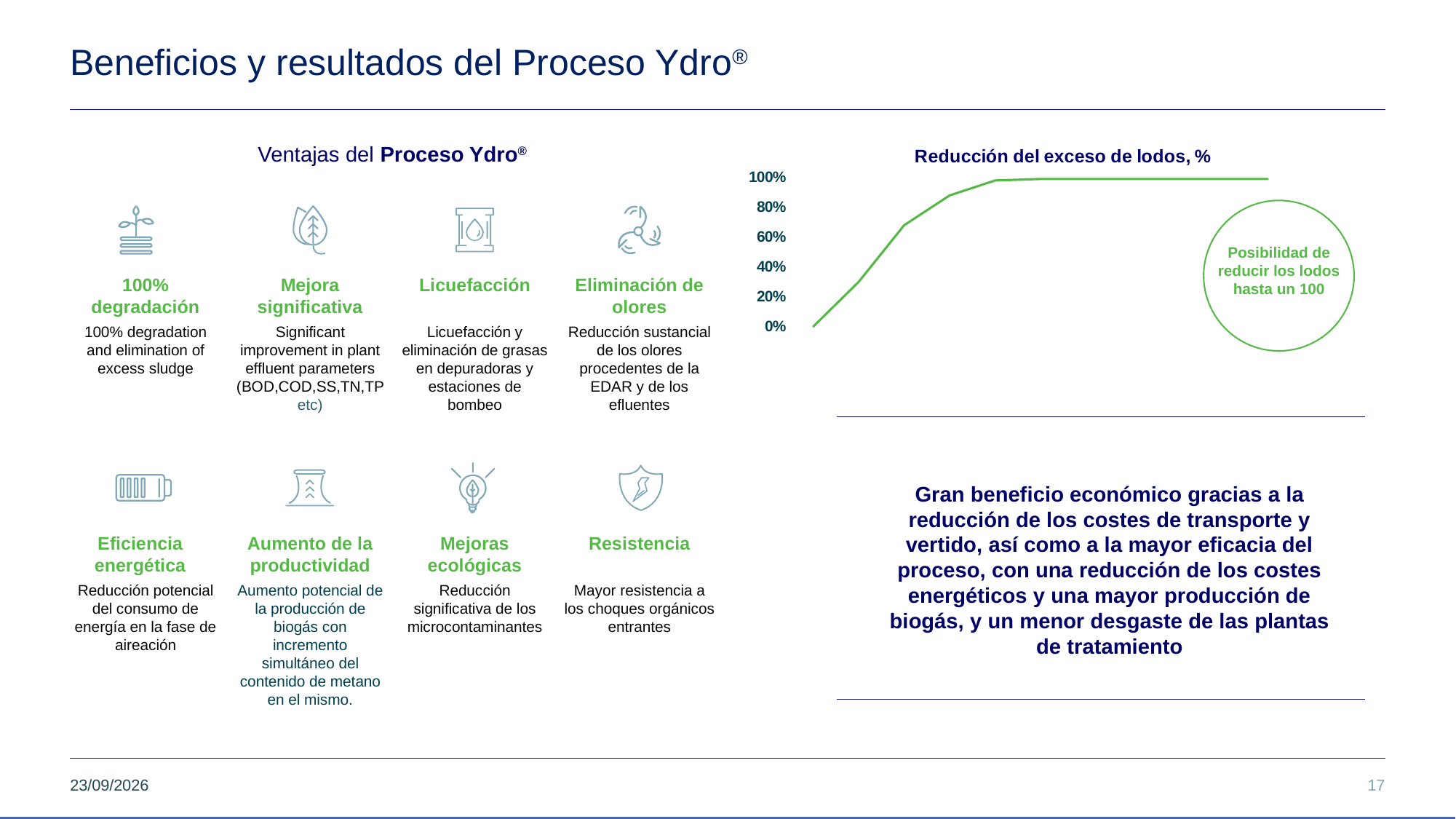
In the chart "Reducción del exceso de lodos, %", what value does the line start at on the left? 0% In the chart "Reducción del exceso de lodos, %", what is the lowest value the line reaches? 0% In the chart "Reducción del exceso de lodos, %", do the values rise or fall along the x axis? rise What is the title of the chart on the right side of the slide? Reducción del exceso de lodos, % In the chart "Reducción del exceso de lodos, %", is the value at the right end of the line greater or less than 80%? greater In the chart "Reducción del exceso de lodos, %", what is the highest tick shown on the y axis? 100% What kind of chart is shown under the title "Reducción del exceso de lodos, %"? line chart In the chart "Reducción del exceso de lodos, %", is the value at the left end of the line greater or less than 20%? less